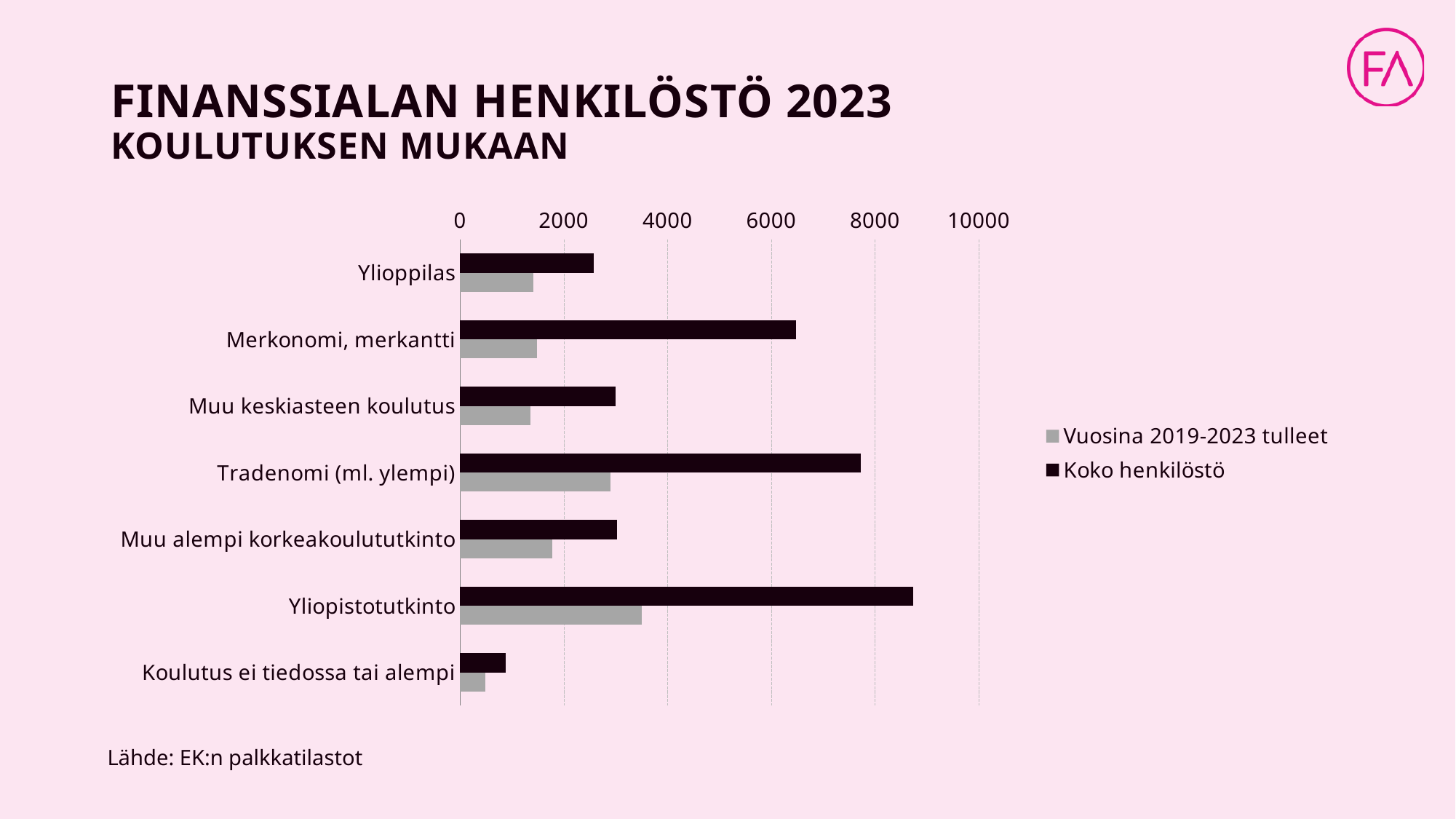
For Koko henkilöstö, which is larger: Merkonomi, merkantti or Tradenomi (ml. ylempi)? Tradenomi (ml. ylempi) Is the Koko henkilöstö value for Tradenomi (ml. ylempi) greater or less than 8000? less Which category has the highest value for Koko henkilöstö? Yliopistotutkinto How many education categories are shown on the chart? 7 What kind of chart is shown on the slide? bar chart Is the Koko henkilöstö value for Yliopistotutkinto greater or less than 8000? greater Is the Vuosina 2019-2023 tulleet value for Yliopistotutkinto greater or less than 4000? less Which category has the highest value for Vuosina 2019-2023 tulleet? Yliopistotutkinto Which category has the lowest value for Koko henkilöstö? Koulutus ei tiedossa tai alempi How many series does the legend list? 2 What is the source cited below the chart? EK:n palkkatilastot